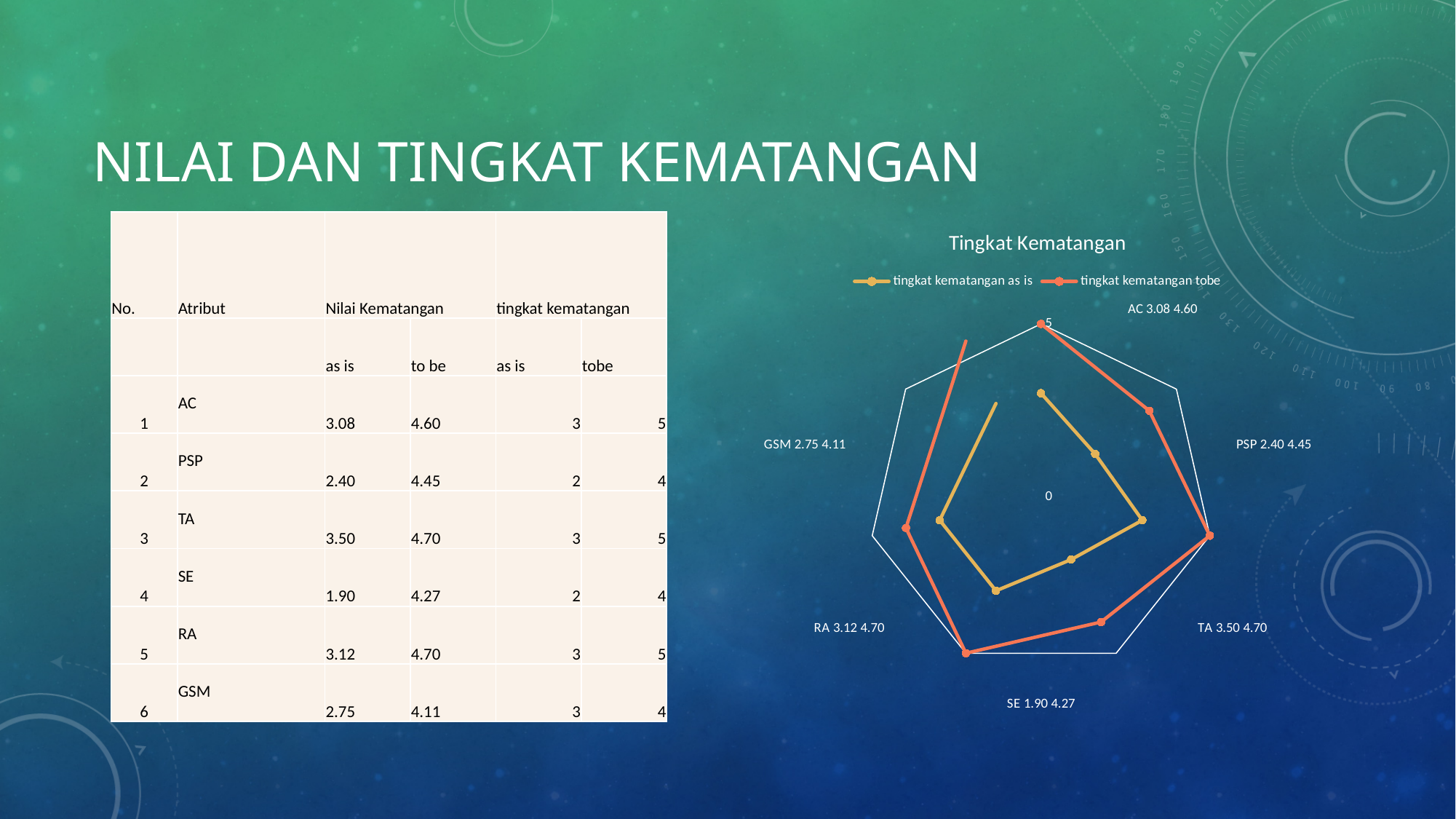
For AC, which series has the larger value in the chart: 'tingkat kematangan as is' or 'tingkat kematangan tobe'? tingkat kematangan tobe Which has the larger 'tingkat kematangan tobe' value in the chart: PSP or TA? TA Is the 'tingkat kematangan tobe' value for PSP greater or less than 5? less How many series does the chart's legend list? 2 What is the value of 'tingkat kematangan tobe' for AC in the chart? 5 How many categories (axes) does the radar chart have? 6 What is the title of the chart on the slide? Tingkat Kematangan What are the two series named in the chart's legend? tingkat kematangan as is; tingkat kematangan tobe Which has the larger 'tingkat kematangan as is' value in the chart: AC or PSP? AC What kind of chart is shown on the slide? radar chart Is the 'tingkat kematangan as is' value for SE greater or less than 5? less